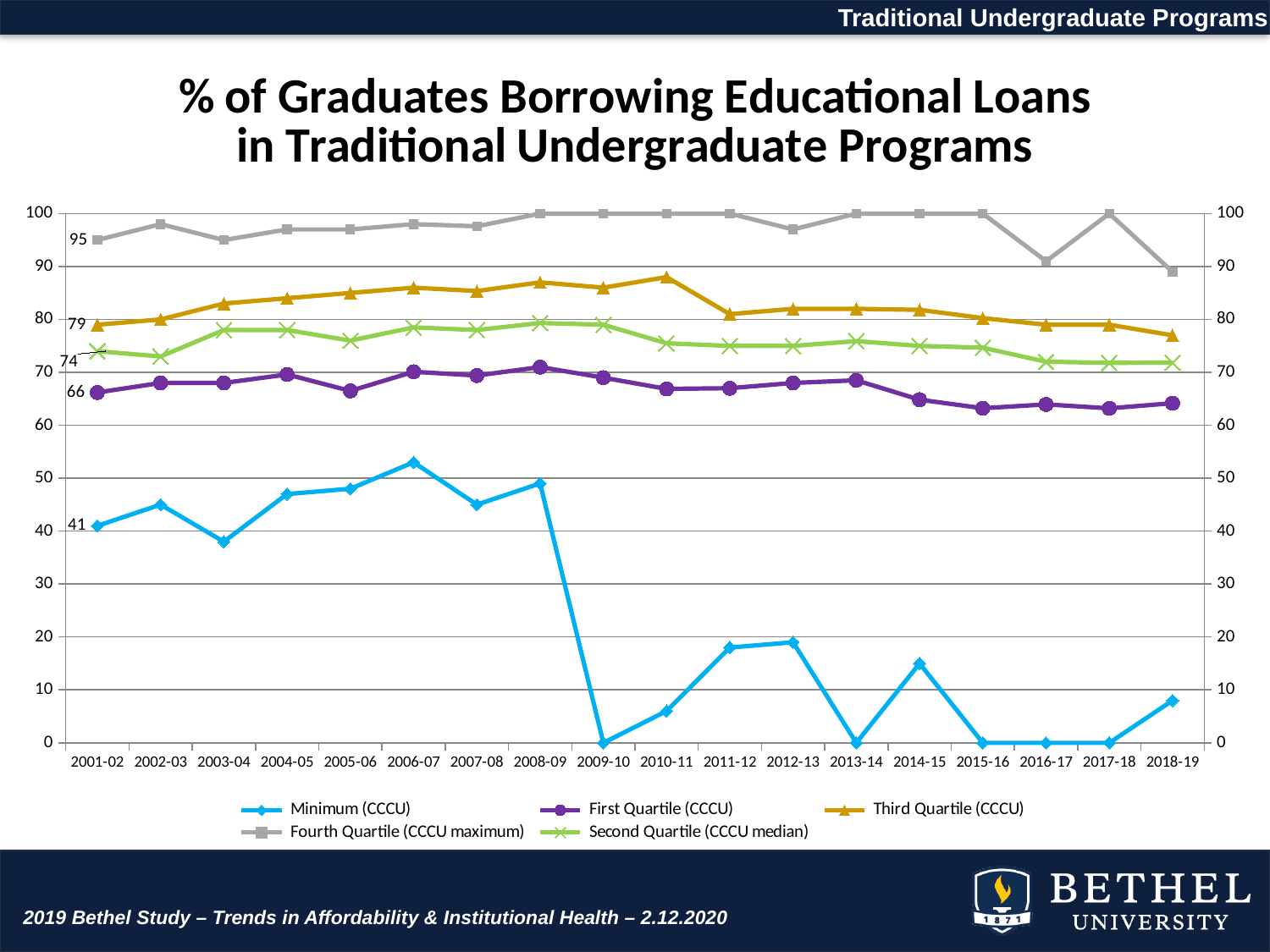
Is the value for Minimum (CCCU) in 2014-15 greater or less than 10? greater What kind of chart is shown on the slide? line chart What is the value for Minimum (CCCU) in 2009-10? 0 What is the value for Second Quartile (CCCU median) in 2001-02? 74 Is the value for Minimum (CCCU) in 2006-07 greater or less than 50? greater What is the value for Third Quartile (CCCU) in 2001-02? 79 What is the value for Fourth Quartile (CCCU maximum) in 2001-02? 95 How many series does the legend list? 5 What is the difference between the Fourth Quartile (CCCU maximum) and the Minimum (CCCU) in 2001-02? 54 What is the difference between the Third Quartile (CCCU) and the First Quartile (CCCU) in 2001-02? 13 What is the value for Minimum (CCCU) in 2001-02? 41 How many academic years are shown on the x axis? 18